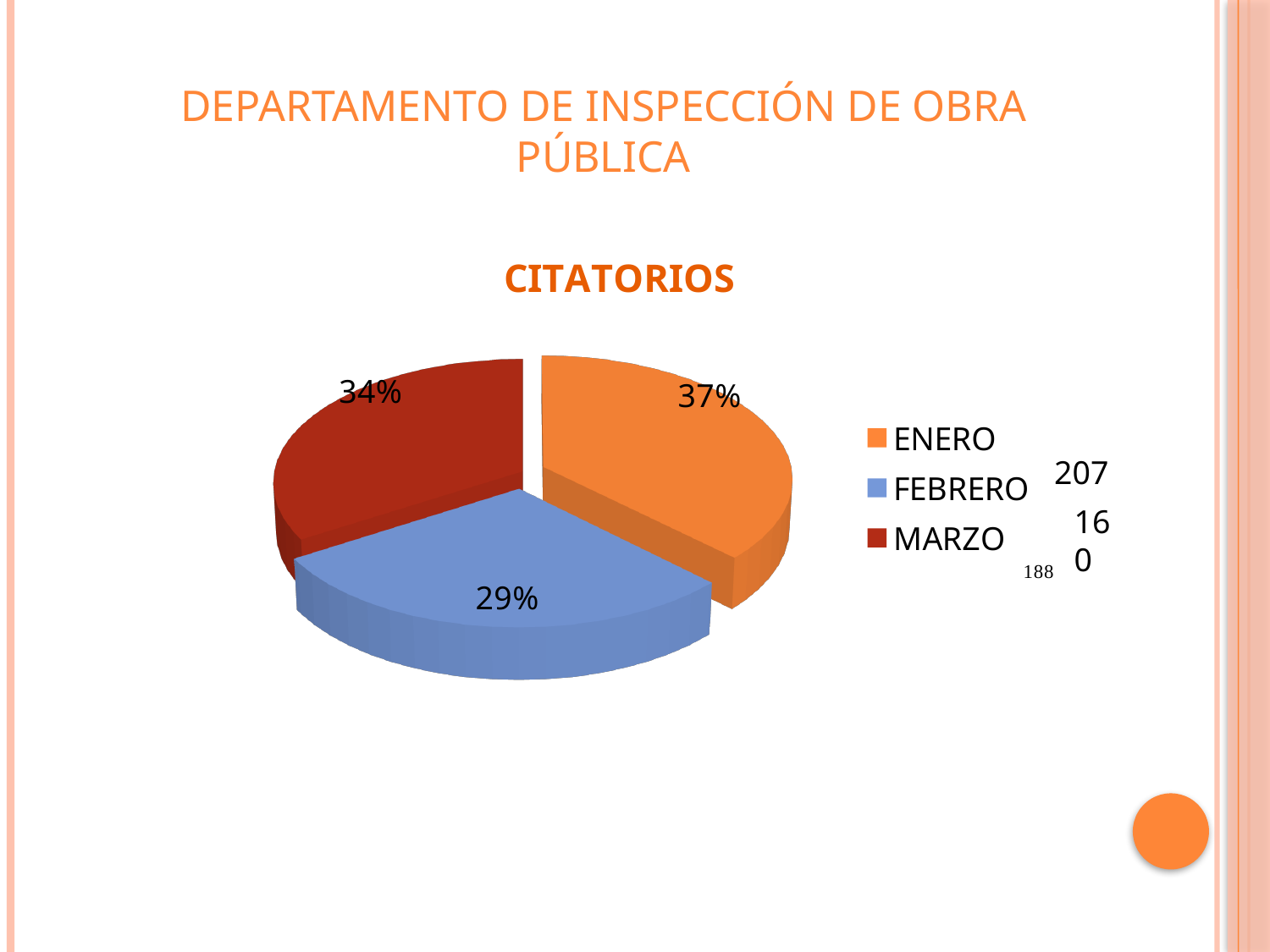
What is the difference in percentage points between the MARZO and FEBRERO slices in the CITATORIOS pie chart? 5 percentage points What colour is the FEBRERO slice in the CITATORIOS pie chart? Blue How many slices does the CITATORIOS pie chart have? 3 What type of chart is shown on the slide? Pie chart Which slice is larger in the CITATORIOS pie chart, MARZO or FEBRERO? MARZO Which month has the smallest slice in the CITATORIOS pie chart? FEBRERO What is the difference in percentage points between the ENERO and FEBRERO slices in the CITATORIOS pie chart? 8 percentage points What share of the CITATORIOS pie chart does ENERO represent? 37% What share of the CITATORIOS pie chart does FEBRERO represent? 29% Which month has the largest slice in the CITATORIOS pie chart? ENERO What share of the CITATORIOS pie chart does MARZO represent? 34% How many entries does the legend of the CITATORIOS chart list? 3